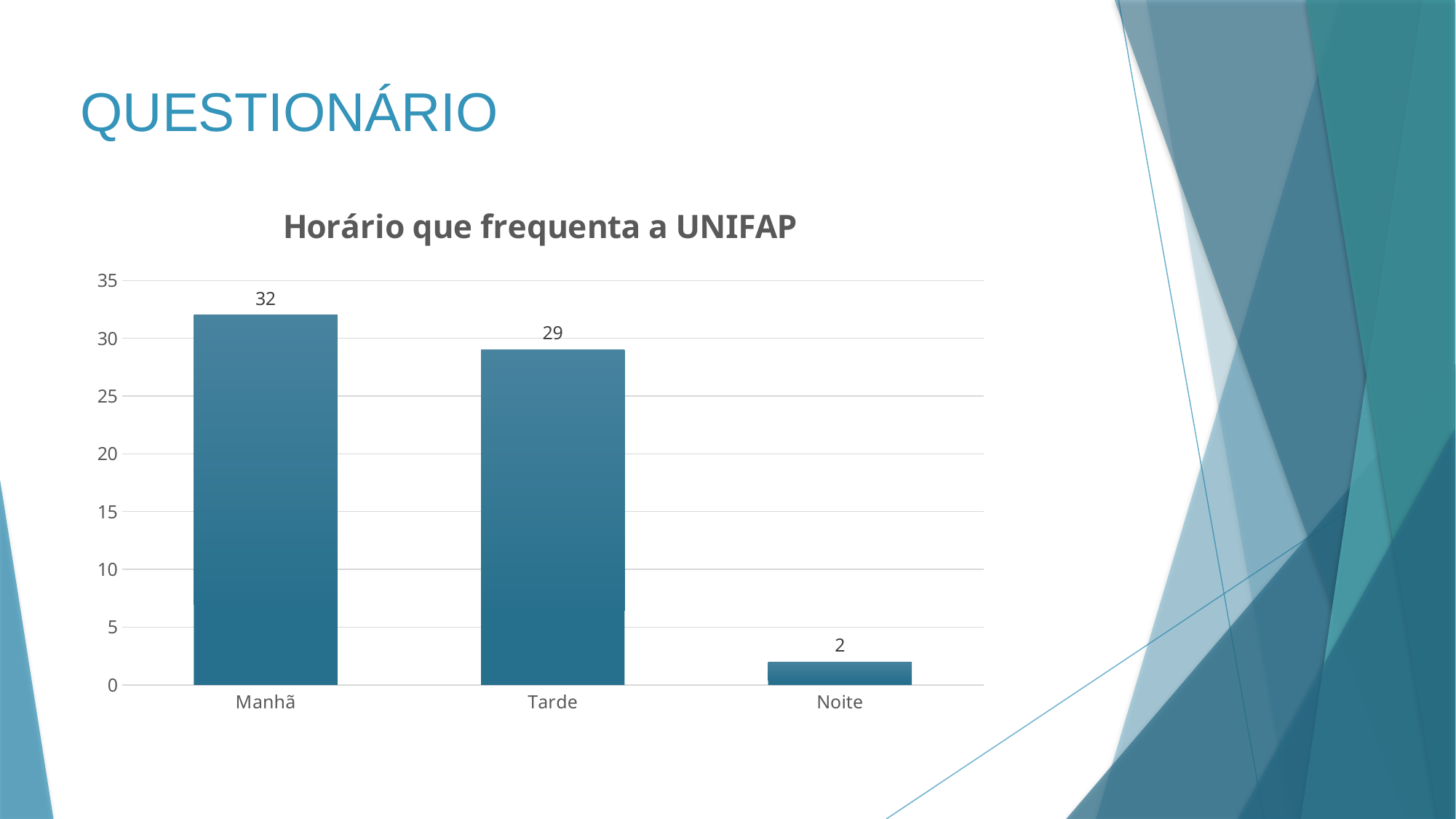
What is the difference between the values for Tarde and Noite? 27 What kind of chart is shown on the slide? Bar chart Is the value for Tarde greater or less than 25? greater Which is larger, the value for Manhã or the value for Tarde? Manhã How many categories are shown on the x axis? 3 What is the value for Manhã? 32 Which category has the lowest value? Noite What is the title of the chart? Horário que frequenta a UNIFAP What is the difference between the values for Manhã and Tarde? 3 Which category has the highest value? Manhã What is the value for Noite? 2 What is the value for Tarde? 29